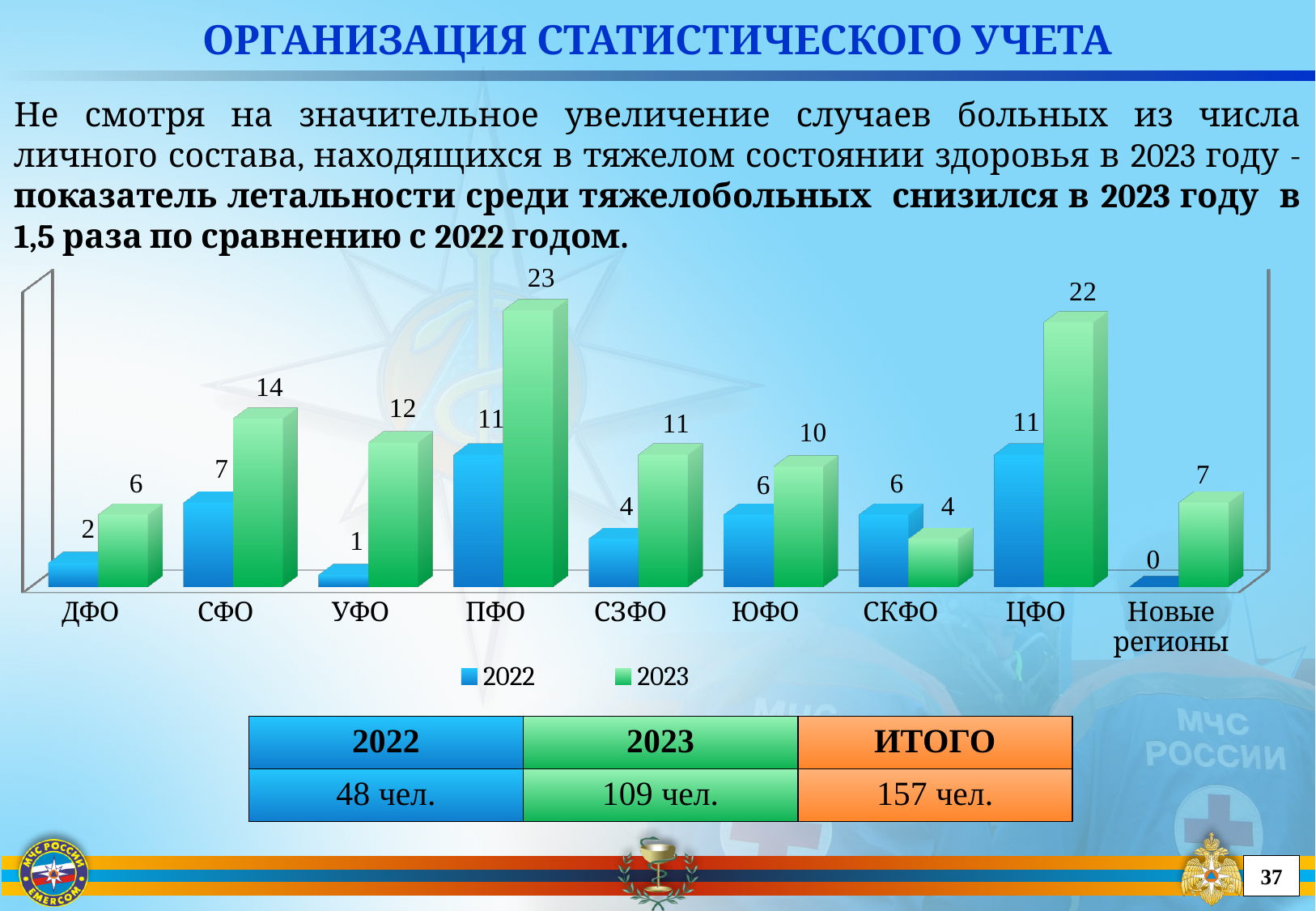
Which category has the lowest value in the 2022 series? Новые регионы What is the value for Новые регионы in the 2022 series? 0 Which category has the highest value in the 2023 series? ПФО What kind of chart is shown on the slide? bar chart Which colour represents the 2023 series in the legend? green How many series does the legend list? 2 How many categories are shown on the x axis? 9 What is the difference between the 2023 and 2022 values for ЦФО? 11 What is the value for ПФО in the 2023 series? 23 What is the difference between the 2023 values for ПФО and УФО? 11 What is the value for СФО in the 2022 series? 7 For СКФО, which series has the larger value, 2022 or 2023? 2022